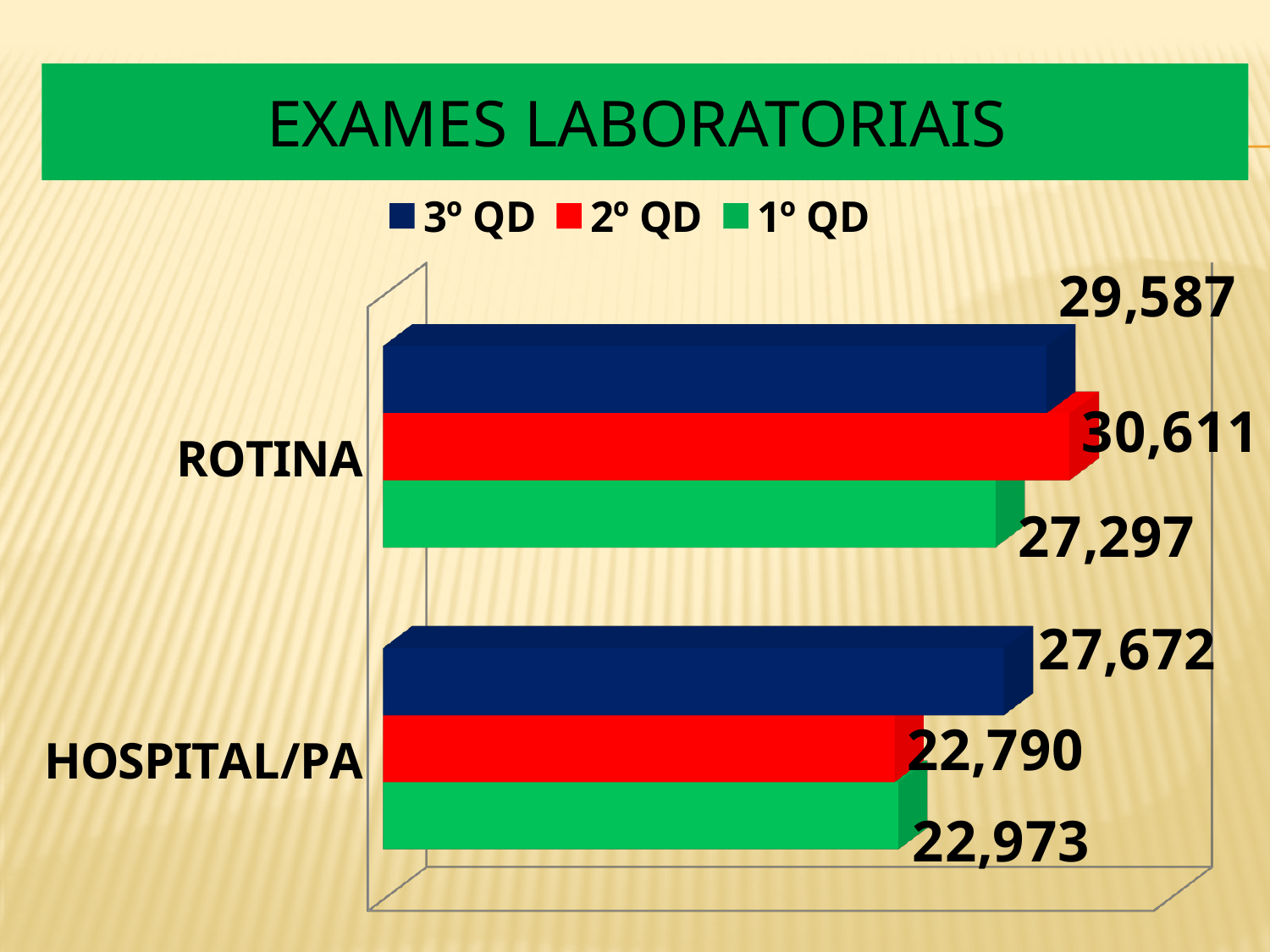
How many categories are shown on the chart? 2 What is the value for 1º QD in the HOSPITAL/PA category? 22,973 Which series has the lowest value in the HOSPITAL/PA category? 2º QD What is the value for 3º QD in the ROTINA category? 29,587 Which is larger for HOSPITAL/PA: the 1º QD value or the 2º QD value? 1º QD What is the value for 2º QD in the ROTINA category? 30,611 What is the value for 2º QD in the HOSPITAL/PA category? 22,790 Which series has the highest value in the ROTINA category? 2º QD What type of chart is shown on the slide? Bar chart What is the difference between the 2º QD and 3º QD values for ROTINA? 1,024 How many series does the legend list? 3 What is the difference between the 3º QD and 2º QD values for HOSPITAL/PA? 4,882